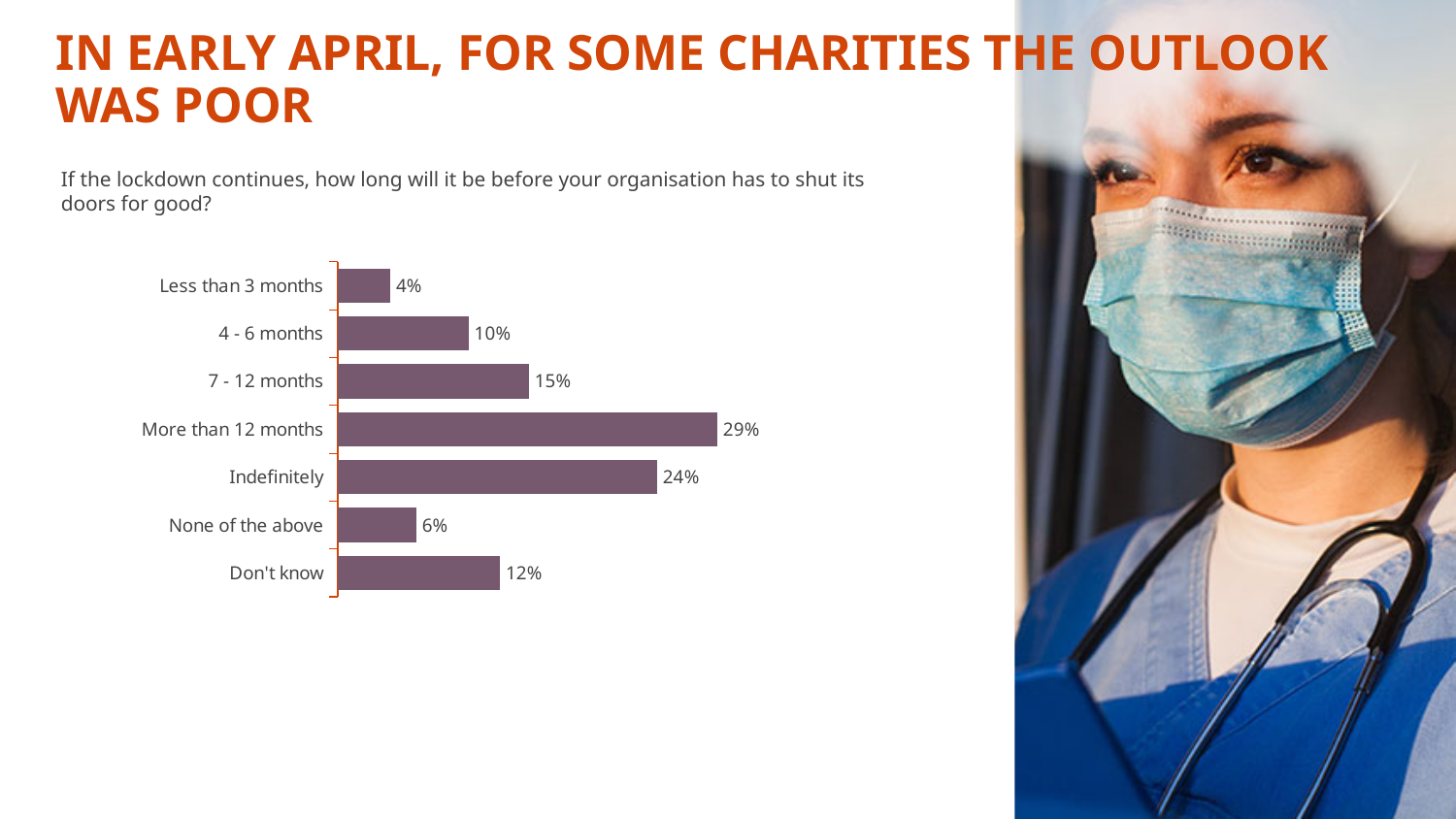
What is the value for 'More than 12 months'? 29% Which category has the highest value? More than 12 months What is the difference between 'Don't know' and 'None of the above'? 6% Which is larger, '4 - 6 months' or '7 - 12 months'? 7 - 12 months What percentage of respondents said 'Less than 3 months'? 4% What is the difference between 'More than 12 months' and 'Indefinitely'? 5% Which category has the lowest value? Less than 3 months How many categories are shown in the chart? 7 What is the value for 'Indefinitely'? 24% What question does the chart report responses to? If the lockdown continues, how long will it be before your organisation has to shut its doors for good? What percentage answered 'Don't know'? 12% What kind of chart is shown on the slide? Bar chart